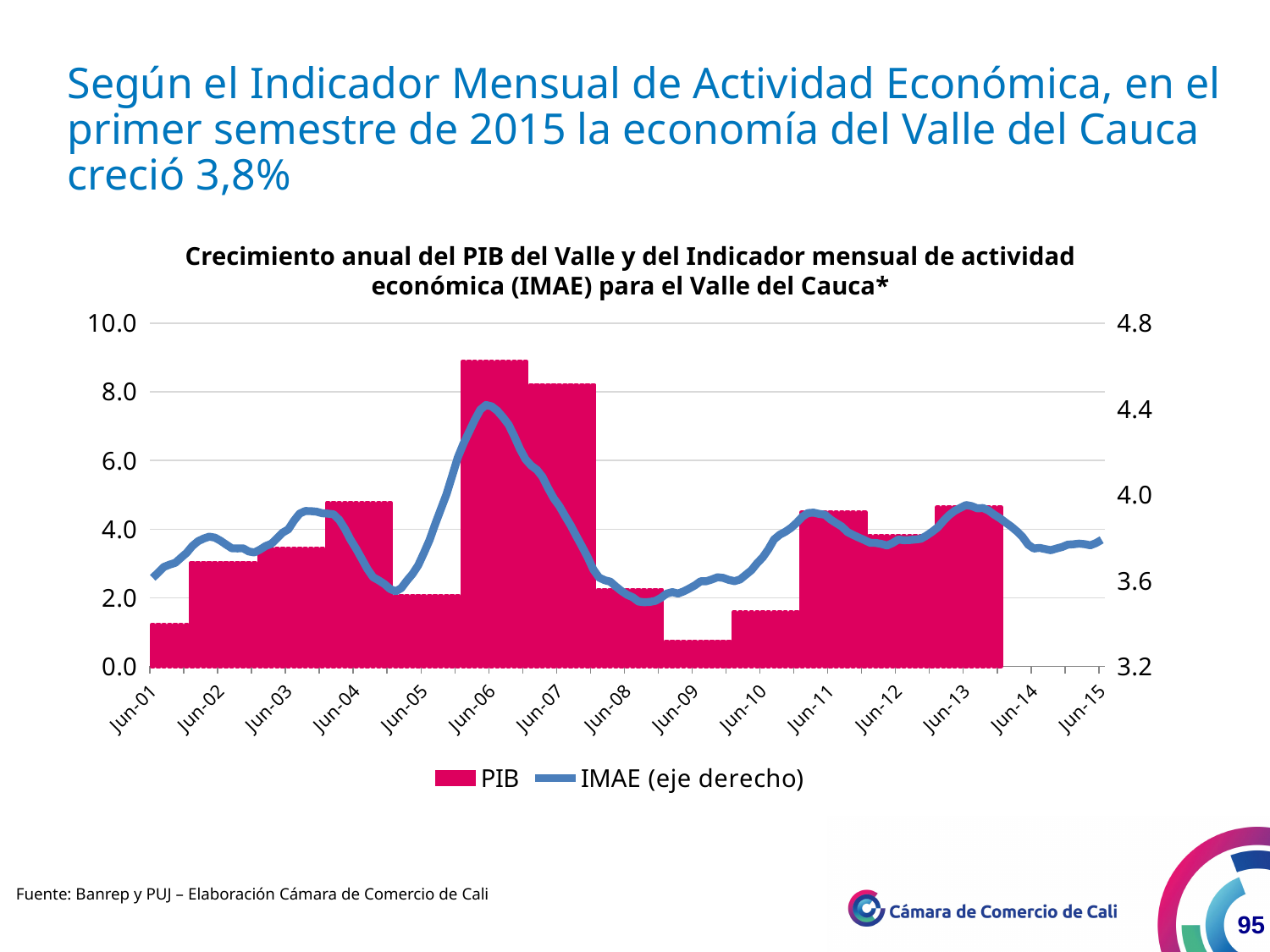
Is the PIB value for Jun-06 greater or less than 8.0? greater Which has the larger PIB value, Jun-04 or Jun-05? Jun-04 What kind of chart is shown on the slide? A combined bar and line chart In which year does the PIB bar reach its highest value? Jun-06 In which year is the PIB bar the lowest? Jun-09 How many series does the legend list? 2 Is the IMAE value at its Jun-06 peak greater or less than 4.0? greater Is the PIB value for Jun-11 greater or less than 4.0? greater Which series is plotted on the right-hand axis? IMAE (eje derecho) Around which year does the IMAE line reach its peak? Jun-06